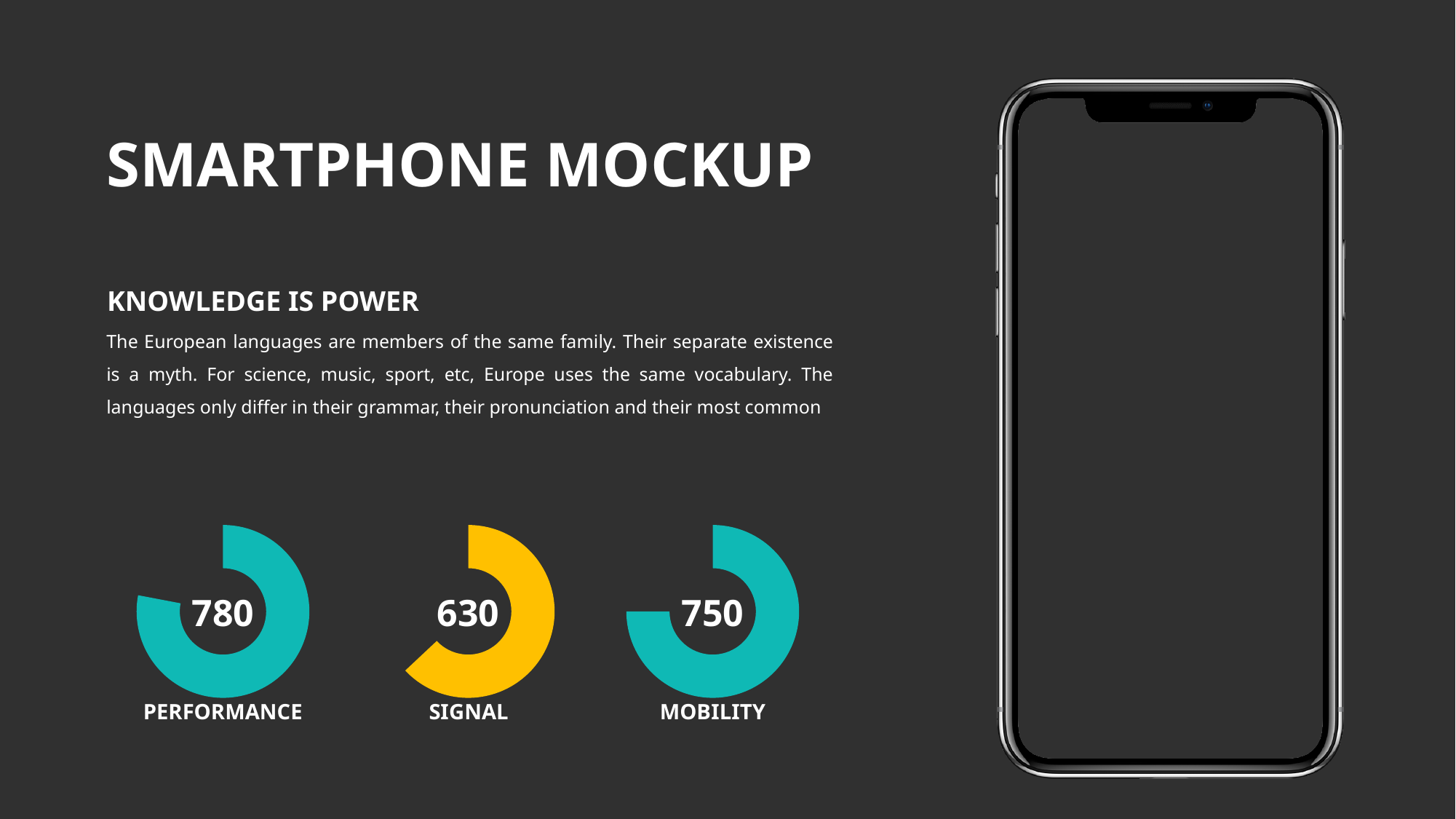
Which of the three ring charts is coloured yellow? SIGNAL What is the difference between the MOBILITY value and the SIGNAL value? 120 How many ring charts are shown on the slide? 3 What is the difference between the PERFORMANCE value and the MOBILITY value? 30 What value is shown in the PERFORMANCE chart? 780 Which is larger, the MOBILITY value or the SIGNAL value? MOBILITY What kind of chart is used to display the PERFORMANCE, SIGNAL and MOBILITY values? Doughnut chart Which of the three ring charts shows the highest value? PERFORMANCE What is the difference between the PERFORMANCE value and the SIGNAL value? 150 What value is shown in the SIGNAL chart? 630 Which of the three ring charts shows the lowest value? SIGNAL What value is shown in the MOBILITY chart? 750